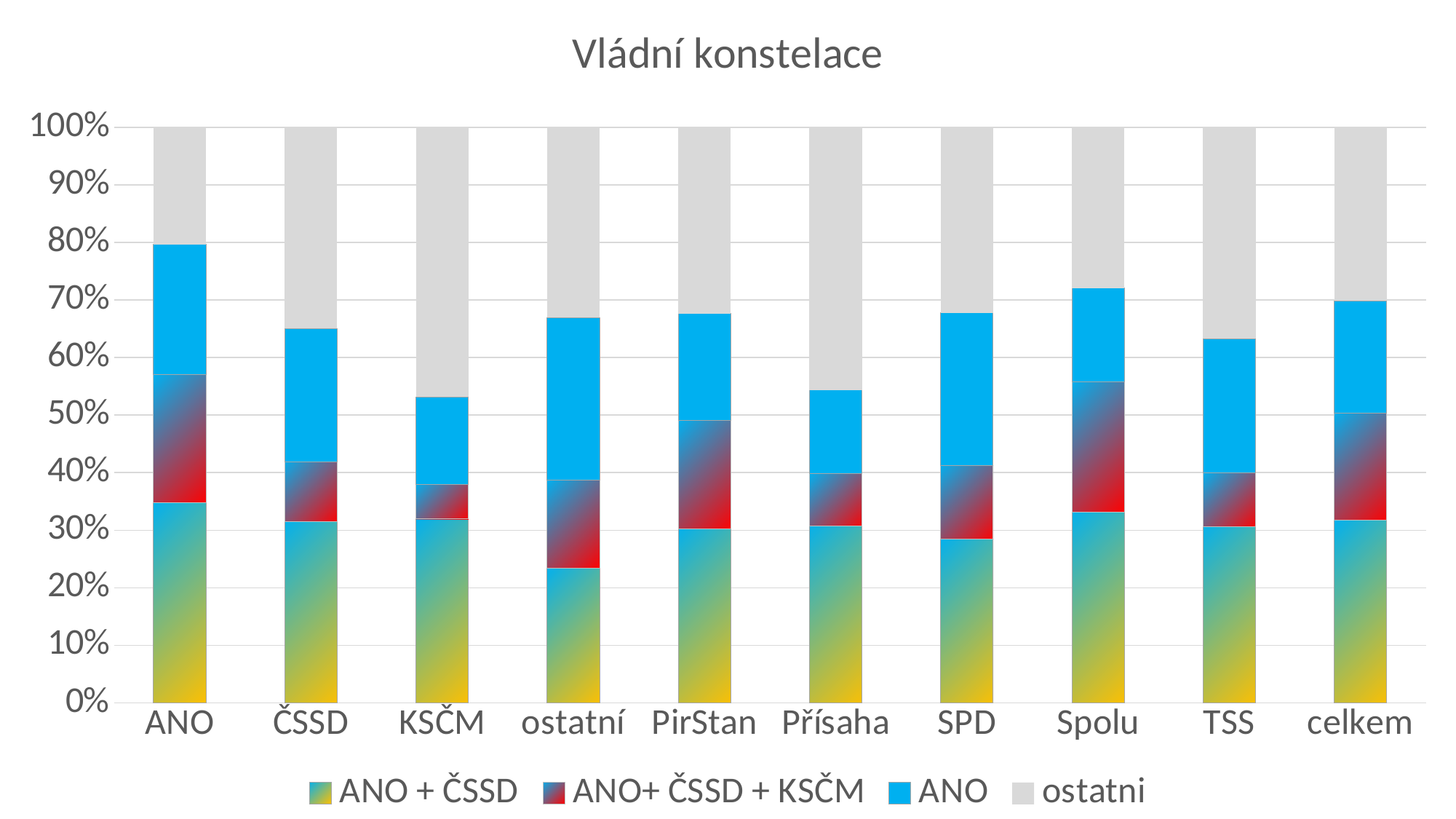
What is the title of the chart? Vládní konstelace Which category has the largest ostatni (grey) segment? KSČM How many categories are shown on the x axis? 10 Is the ANO + ČSSD segment larger for ANO or for ostatní? ANO Is the ostatni (grey) segment for KSČM greater or less than 40%? greater What type of chart is shown on the slide? stacked bar chart How many series does the legend list? 4 Is the ANO + ČSSD segment for ANO greater or less than 30%? greater Is the ANO + ČSSD segment for ostatní greater or less than 30%? less Which category has the smallest ostatni (grey) segment? ANO Which category has the smallest ANO + ČSSD segment? ostatní Which series is shown in grey in the legend? ostatni